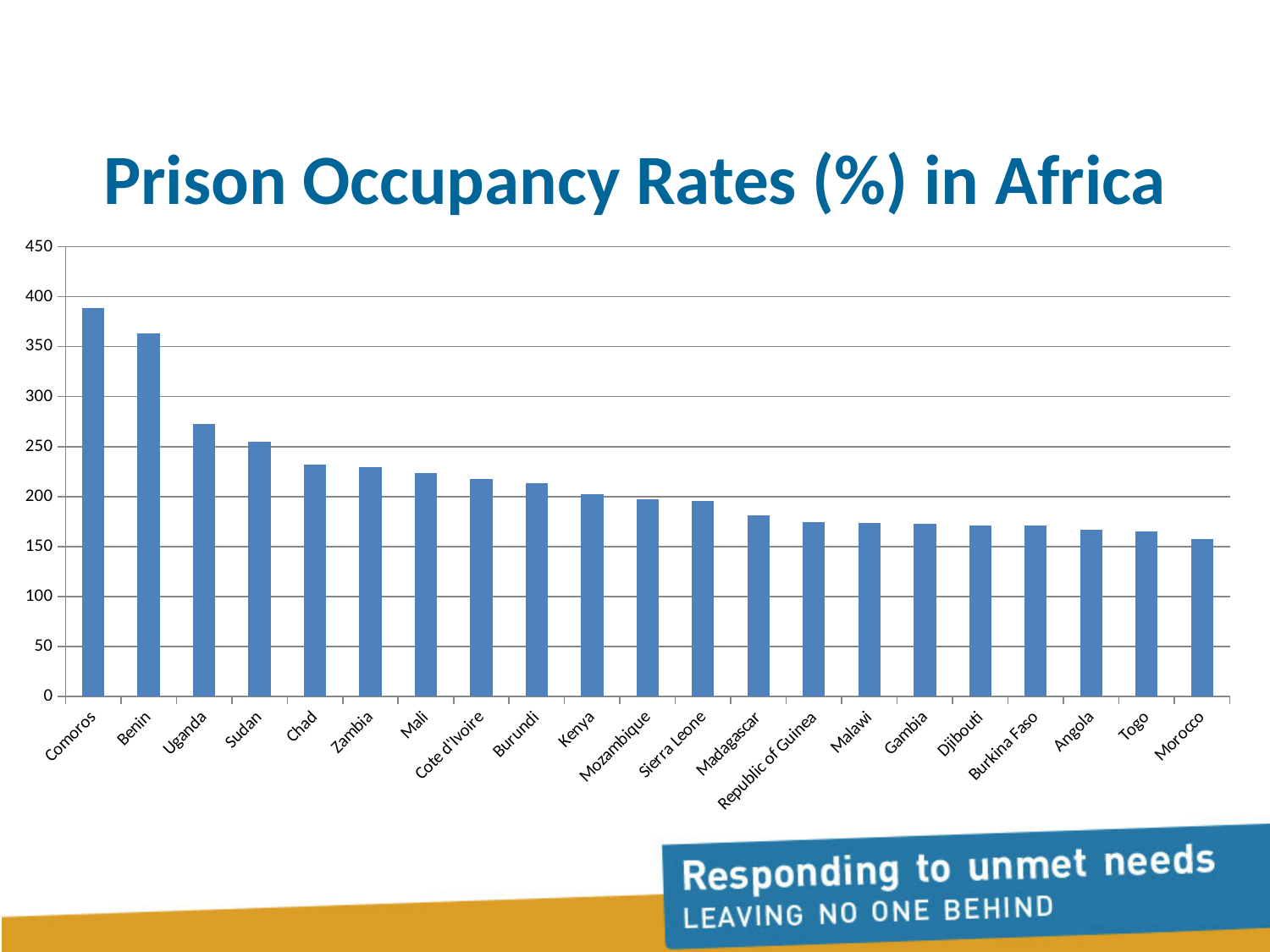
Is the value for Madagascar greater or less than 200? less How many countries are shown in the chart? 21 Is the value for Morocco greater or less than 200? less What is the title of the chart? Prison Occupancy Rates (%) in Africa Which country has the lowest prison occupancy rate in the chart? Morocco Is the value for Comoros greater or less than 350? greater What type of chart is shown on the slide? bar chart Which country has the highest prison occupancy rate in the chart? Comoros Which has a higher prison occupancy rate, Comoros or Benin? Comoros Do the values rise or fall moving from left to right along the x axis? fall